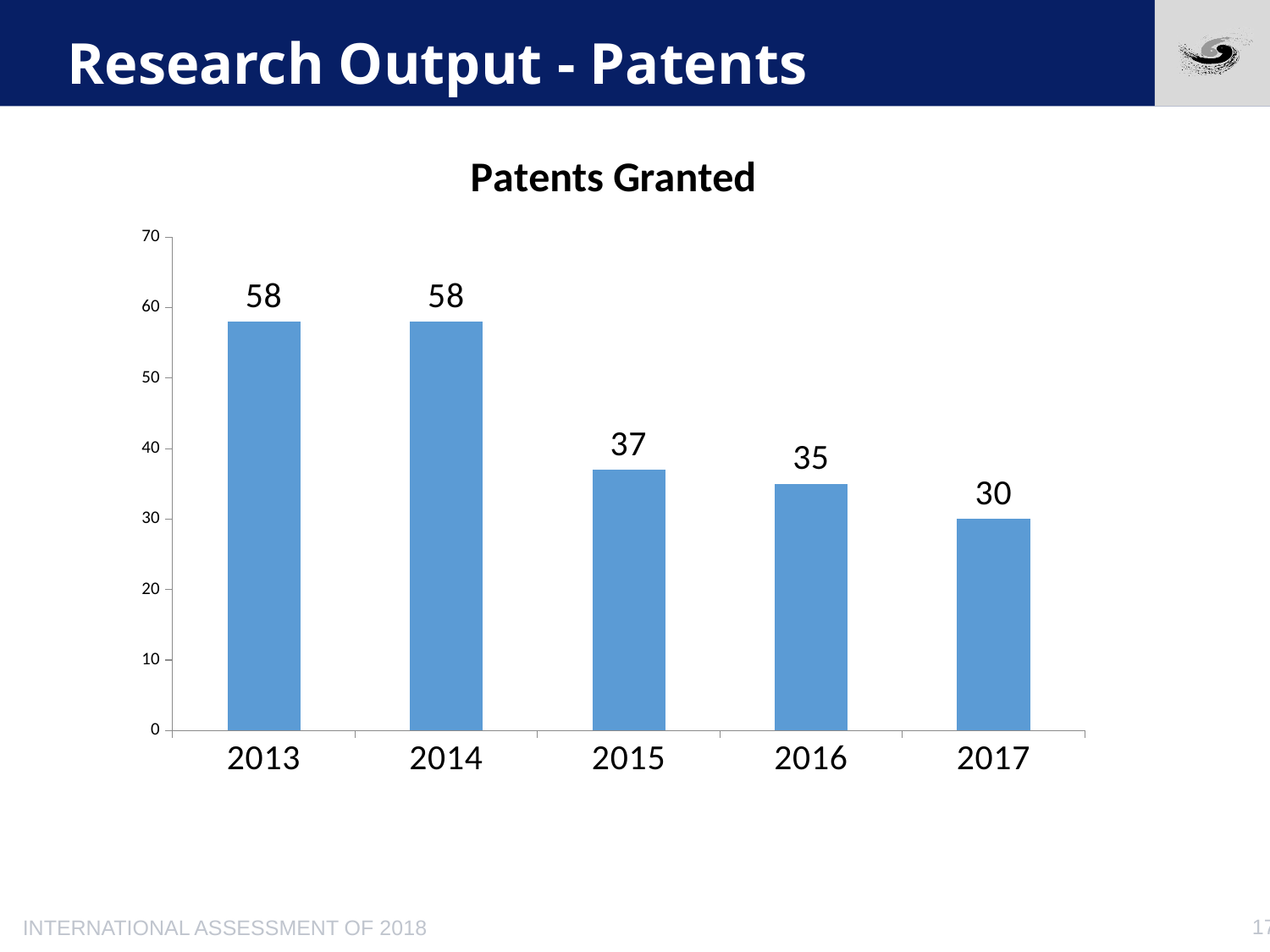
What is the title of the chart? Patents Granted How many patents were granted in 2016? 35 What kind of chart is shown on the slide? Bar chart Do the values generally rise or fall from 2013 to 2017? Fall Which year has the lowest number of patents granted? 2017 How many years are shown on the x axis of the chart? 5 Which year has the larger value, 2015 or 2016? 2015 How many patents were granted in 2015? 37 What is the value shown for 2017 in the Patents Granted chart? 30 What is the difference between the patents granted in 2014 and in 2015? 21 Is the value for 2013 greater or less than 50? greater What is the difference between the values for 2016 and 2017? 5